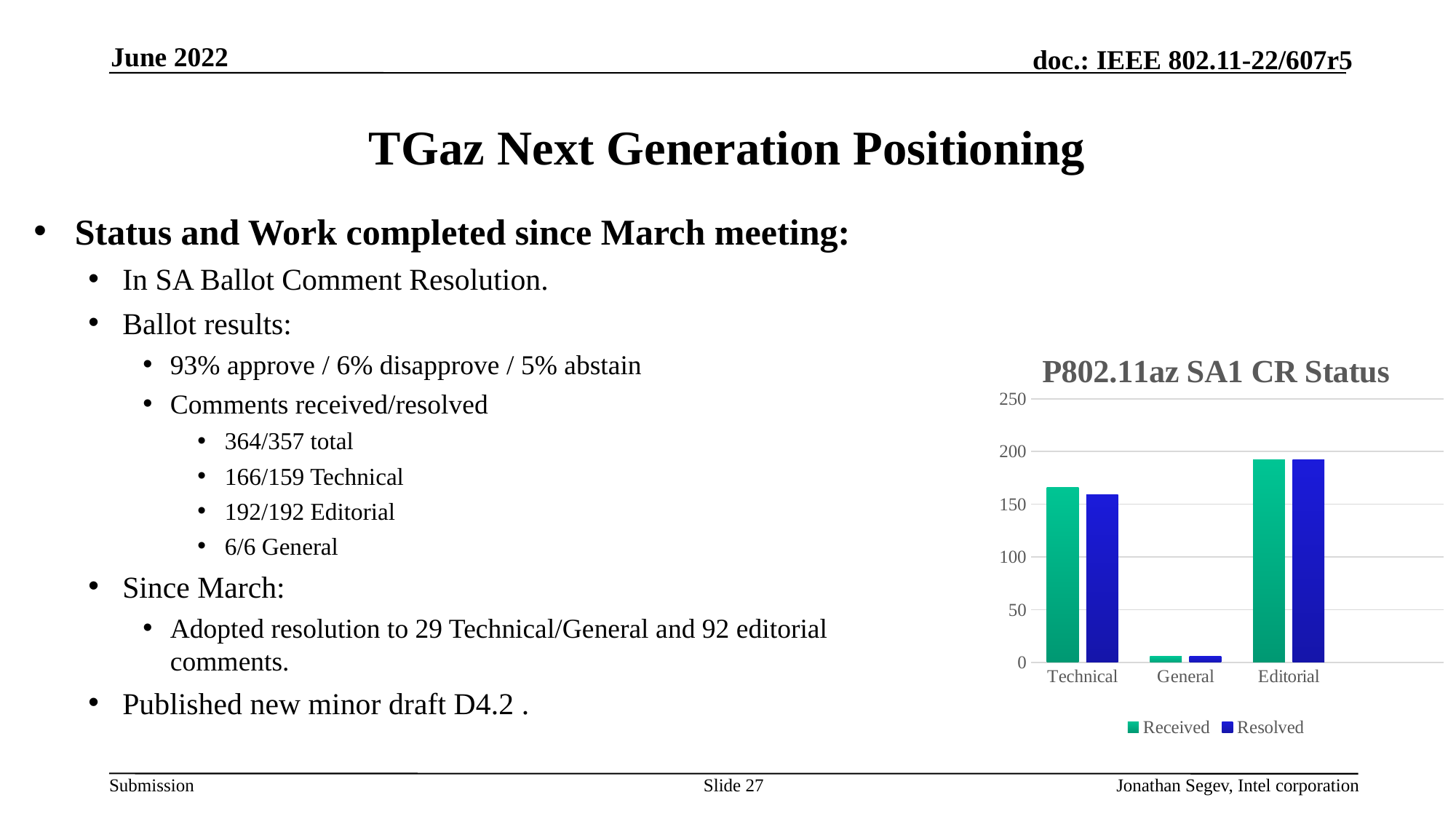
Is the Received value for General greater or less than 50? less What type of chart is shown on the slide? bar chart Which series is shown in blue in the chart? Resolved Is the Received value for Editorial greater or less than 150? greater Which is larger in the chart: the Received value for Editorial or the Received value for Technical? Editorial Is the Resolved value for Editorial greater or less than 200? less How many categories are shown on the x axis of the chart? 3 What is the title of the chart? P802.11az SA1 CR Status Which category has the lowest Resolved value in the chart? General How many series does the chart legend list? 2 Which category has the highest Received value in the chart? Editorial